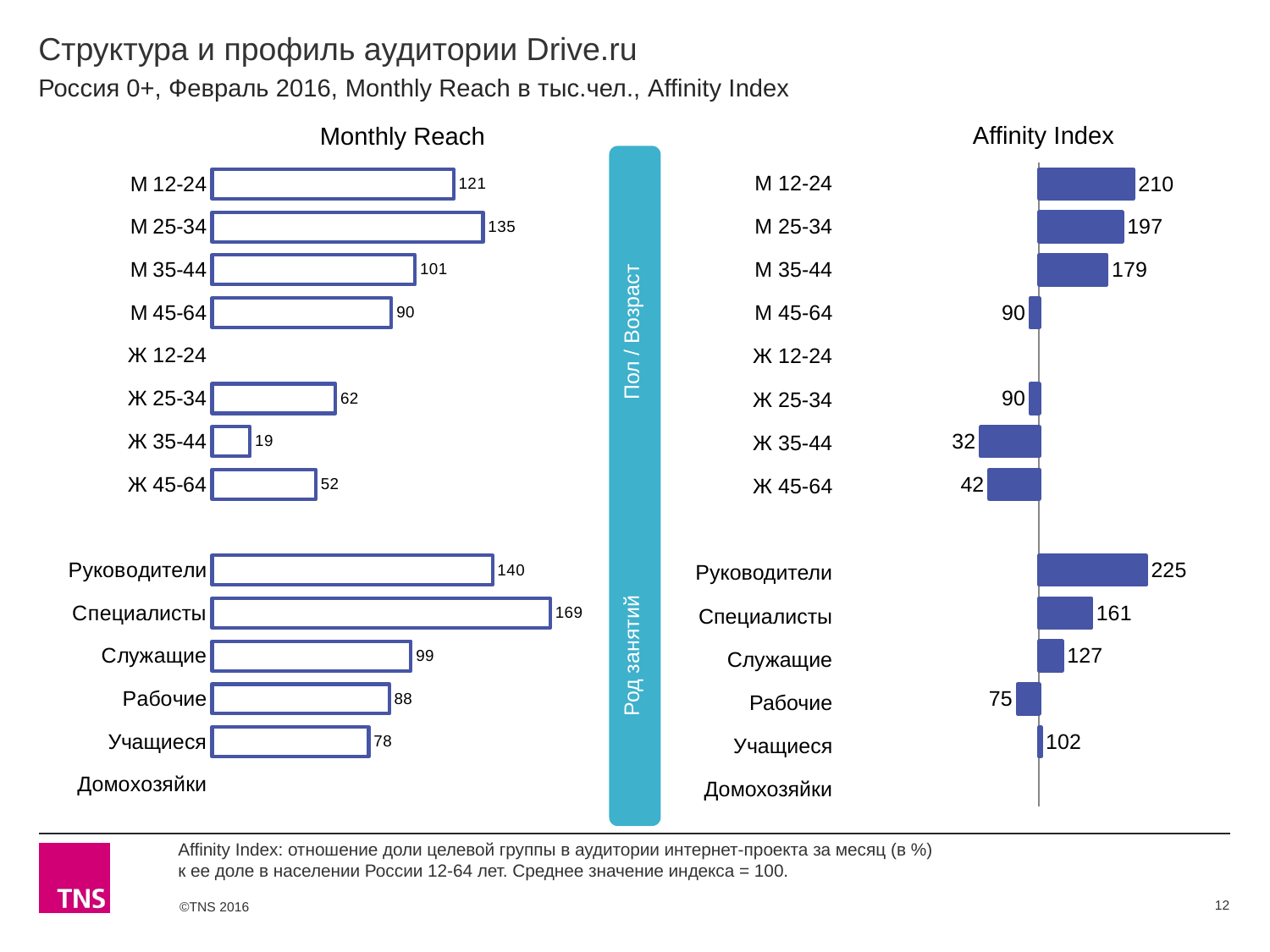
In the Affinity Index chart, which category has the lowest value? Ж 35-44 In the Affinity Index chart, do the values rise or fall going from М 12-24 down to М 45-64? Fall In the Monthly Reach chart, what is the value for М 25-34? 135 In the Monthly Reach chart, which is larger: М 35-44 or Служащие? М 35-44 In the Monthly Reach chart, what is the difference between Руководители and Учащиеся? 62 In the Affinity Index chart, what is the difference between М 12-24 and М 25-34? 13 In the Affinity Index chart, which is larger: Рабочие or Учащиеся? Учащиеся In the Affinity Index chart, what is the value for Ж 45-64? 42 In the Monthly Reach chart, which labelled category has the lowest value? Ж 35-44 In the Affinity Index chart, what is the value for Руководители? 225 In the Monthly Reach chart, which category has the highest value? Специалисты What type of chart is the Monthly Reach chart? Bar chart